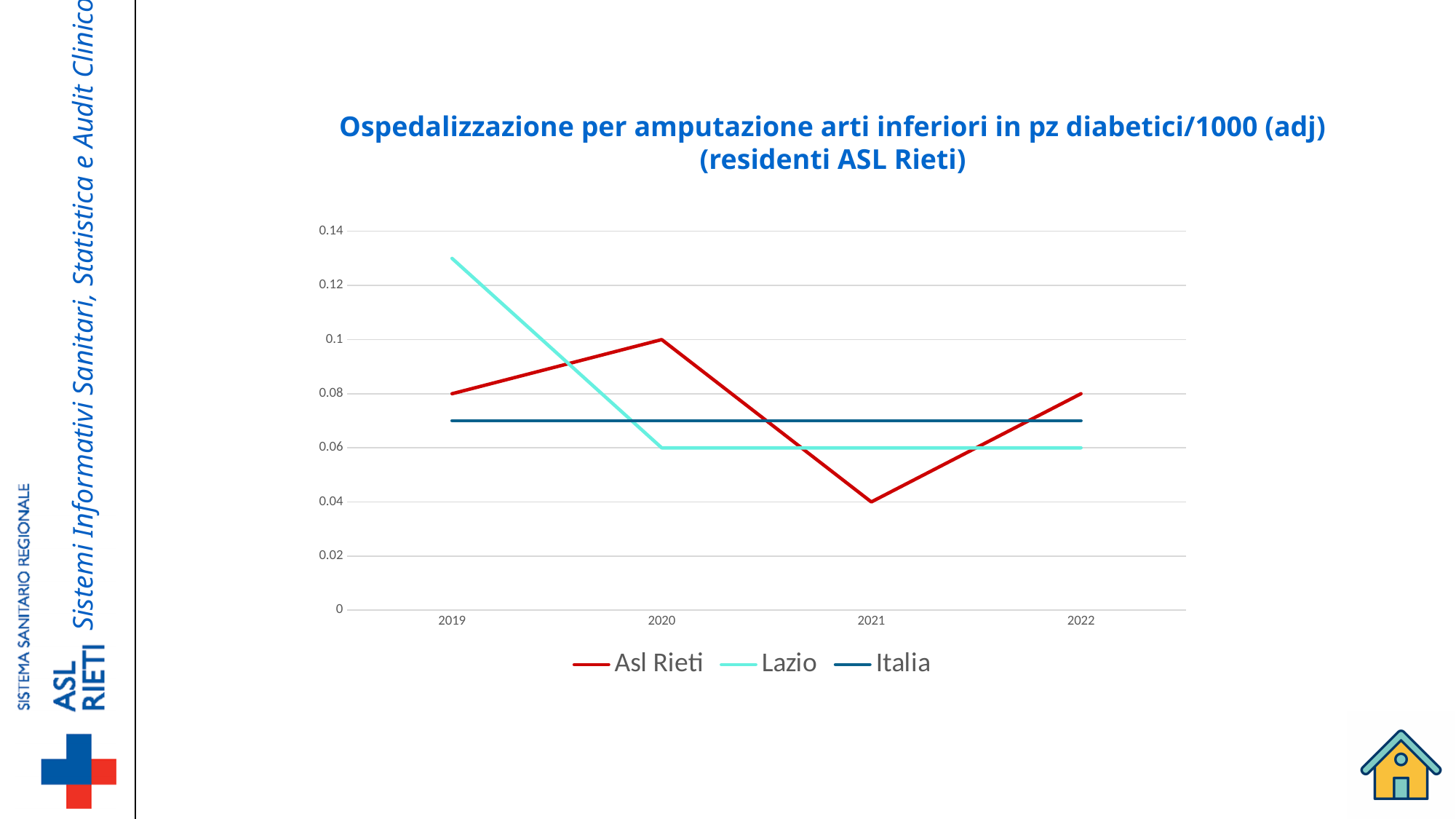
What is the value for Lazio in 2021? 0.06 In which year is the Asl Rieti value lowest? 2021 How many series does the legend list? 3 Is the value for Lazio in 2019 greater or less than 0.12? greater What is the difference between the Asl Rieti values in 2020 and 2021? 0.06 How many years are shown on the x axis? 4 In 2020, which is larger: Asl Rieti or Lazio? Asl Rieti In which year is the Asl Rieti value highest? 2020 Is the value for Italia in 2020 greater or less than 0.06? greater What is the value for Asl Rieti in 2021? 0.04 What is the value for Asl Rieti in 2020? 0.1 What kind of chart is shown on the slide? line chart